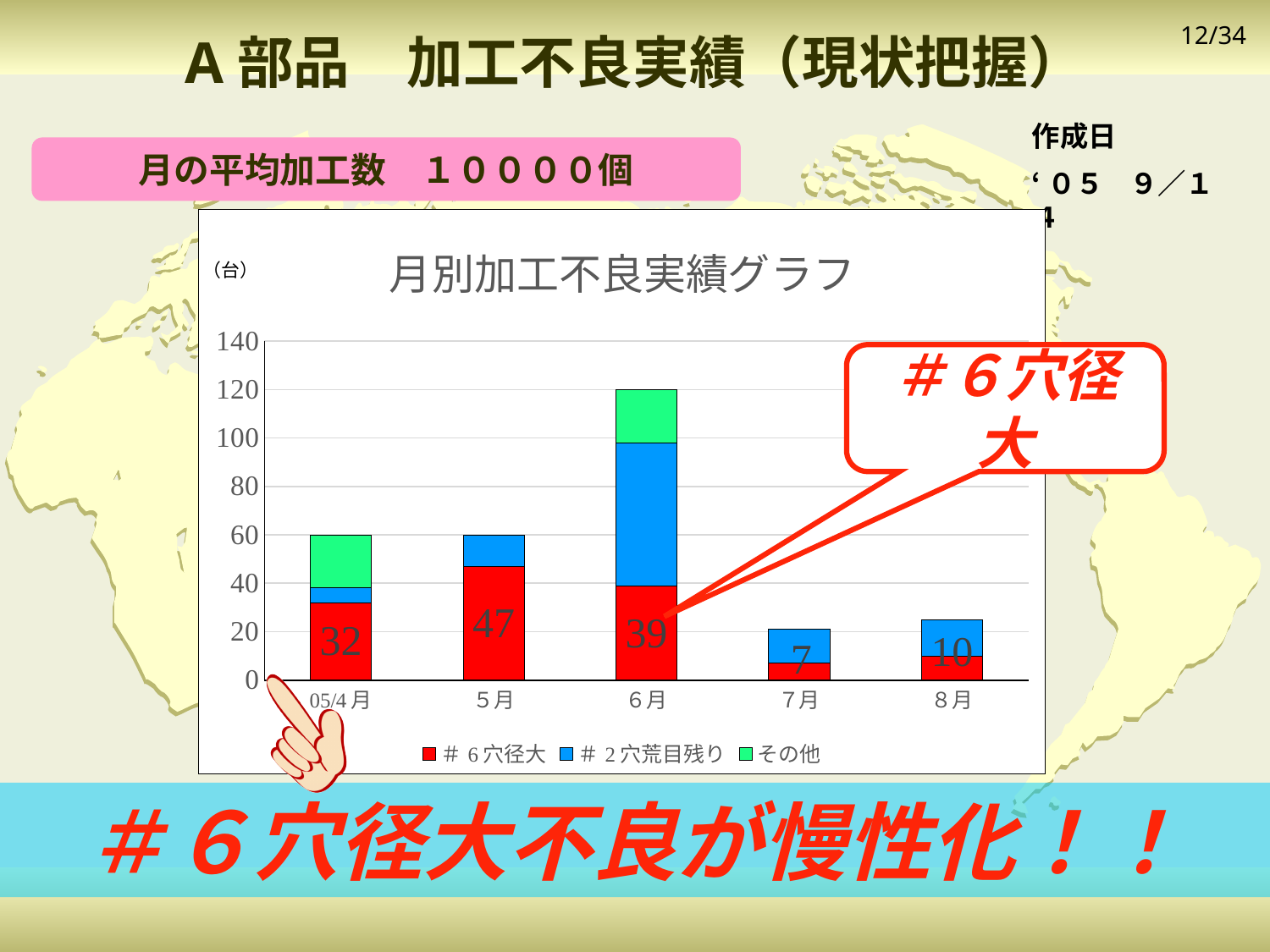
How many series does the legend list? 3 Which month has the lowest value for ＃６穴径大? 7月 What is the value of ＃６穴径大 for 7月? 7 What type of chart is shown on the slide? stacked bar chart Which month has the highest value for ＃６穴径大? 5月 What is the value of ＃６穴径大 for 5月? 47 How many months are shown on the x axis? 5 Is the ＃６穴径大 value for 6月 larger than that for 8月? Yes Is the total stacked value for 6月 greater or less than 100? greater What is the title of the chart? 月別加工不良実績グラフ What is the value of ＃６穴径大 for 05/4月? 32 What is the difference between the ＃６穴径大 values for 5月 and 05/4月? 15